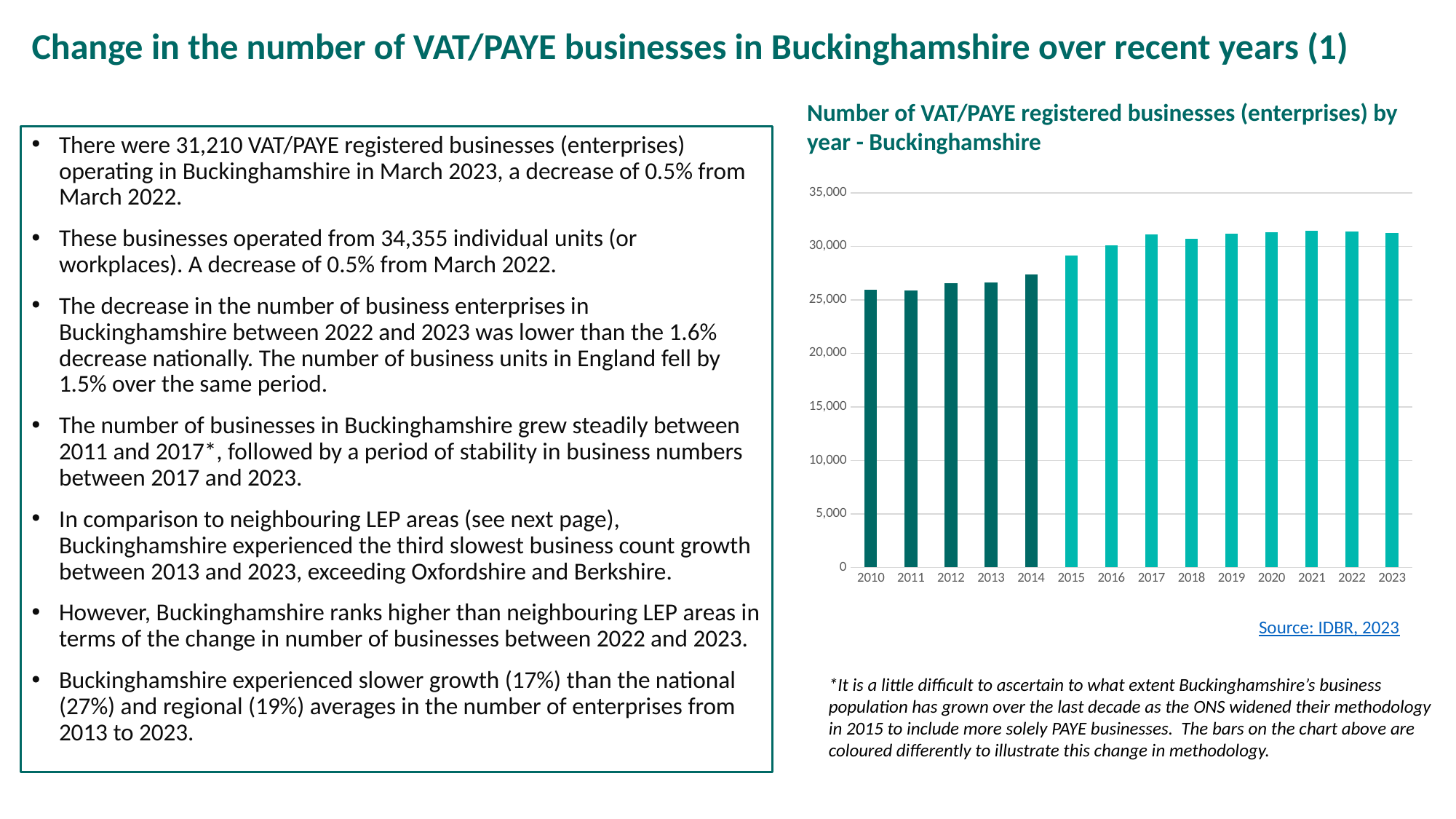
Is the value for 2014 greater or less than 25,000? greater Do the values generally rise or fall between 2010 and 2017? Rise How many years are shown on the x axis of the chart? 14 Which year has the larger value, 2010 or 2017? 2017 Is the value for 2017 greater or less than 30,000? greater What is the title of the chart? Number of VAT/PAYE registered businesses (enterprises) by year - Buckinghamshire Is the value for 2010 greater or less than 30,000? less Which years' bars are coloured in the darker shade of teal? 2010 to 2014 Which year has the larger value, 2014 or 2015? 2015 What kind of chart is shown on the slide? Bar chart